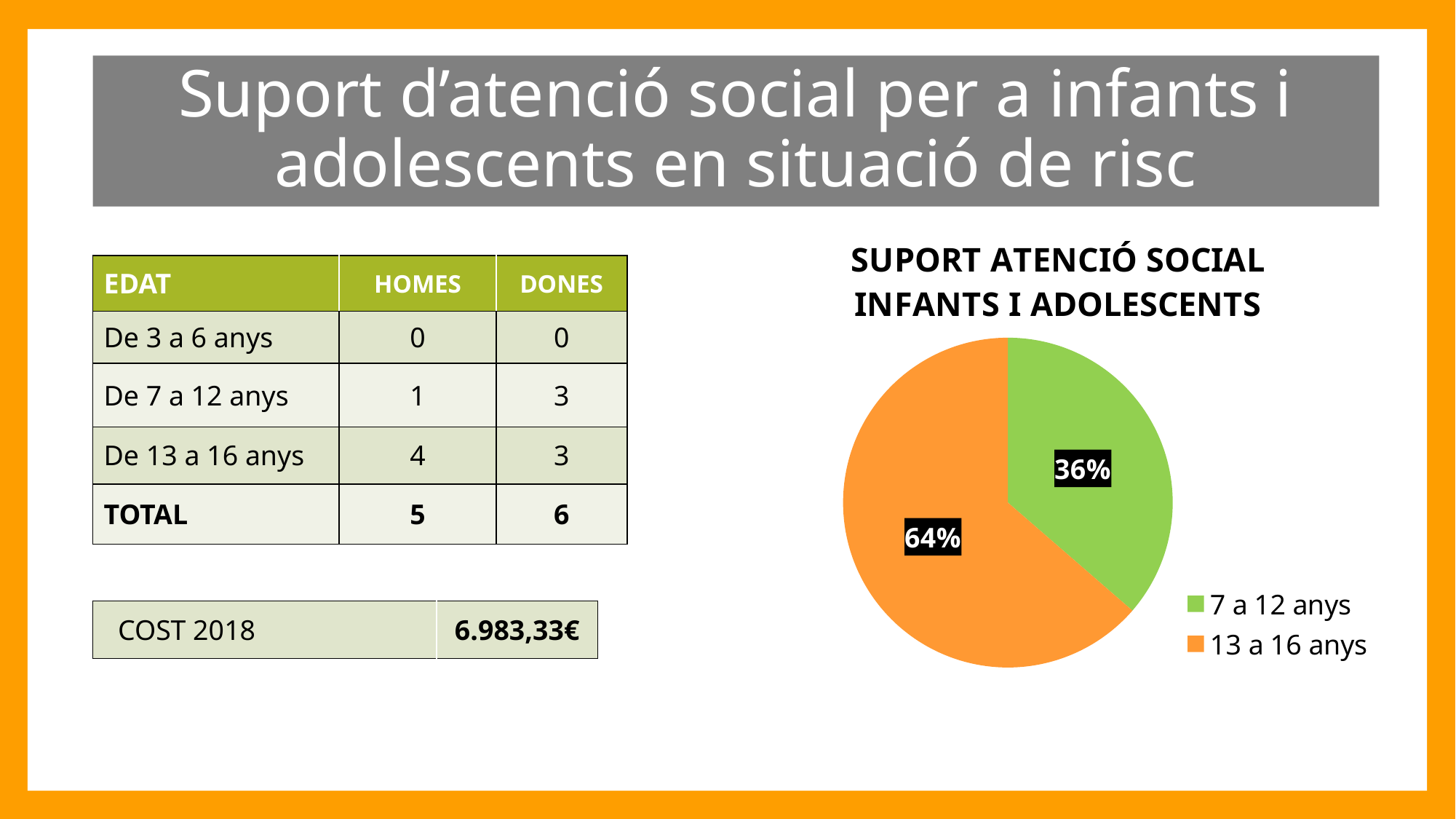
Which slice of the pie chart is the smallest? 7 a 12 anys Which slice of the pie chart is the largest? 13 a 16 anys What is the difference in percentage points between the '13 a 16 anys' slice and the '7 a 12 anys' slice? 28 How many entries does the pie chart legend list? 2 What kind of chart is shown on the slide? pie chart How many slices does the pie chart have? 2 Which is larger in the pie chart: the '7 a 12 anys' slice or the '13 a 16 anys' slice? 13 a 16 anys What colour is the '13 a 16 anys' slice in the pie chart? orange What share of the pie does the '7 a 12 anys' slice represent? 36% What share of the pie does the '13 a 16 anys' slice represent? 64% What is the title of the pie chart? SUPORT ATENCIÓ SOCIAL INFANTS I ADOLESCENTS